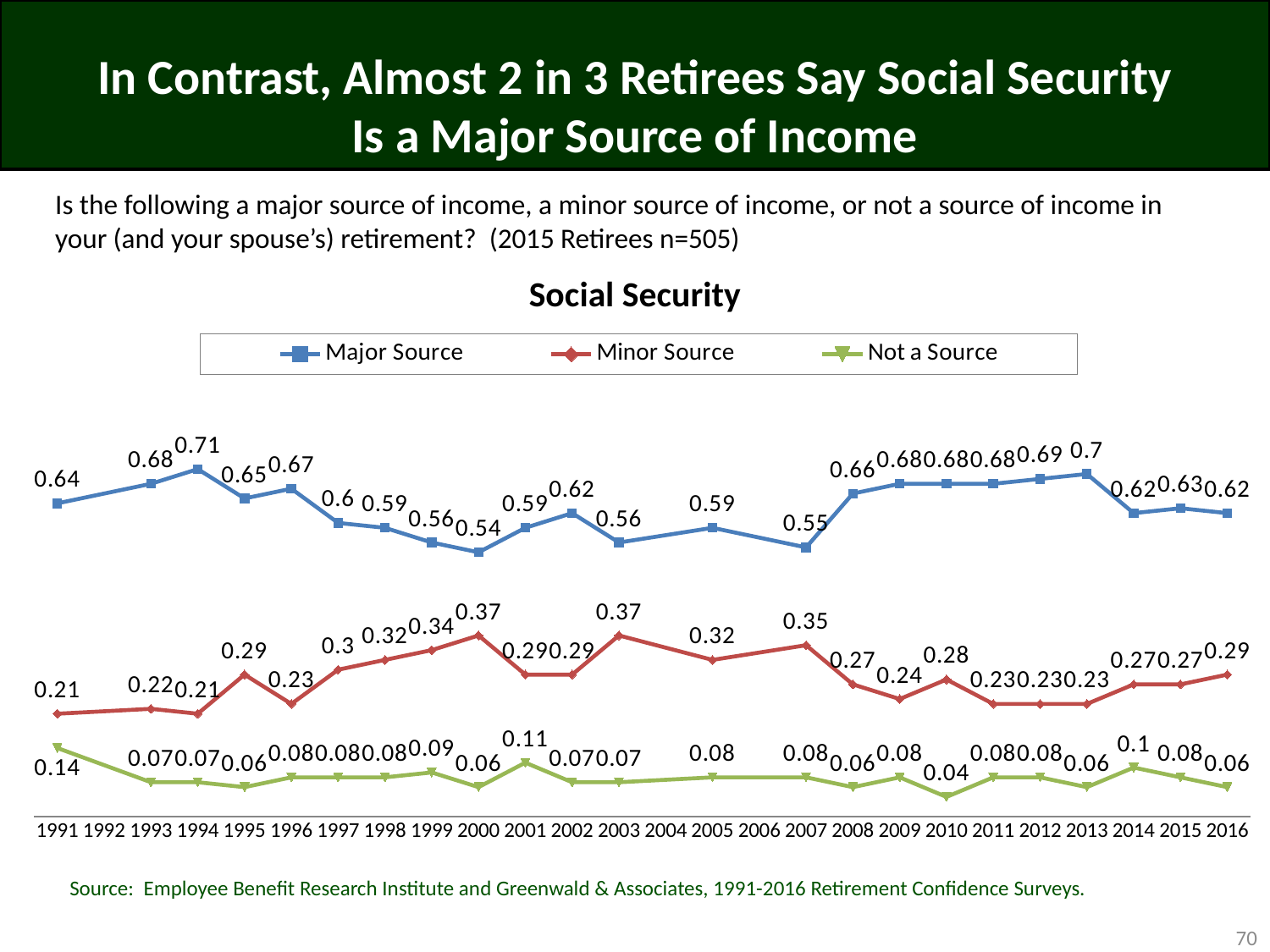
Which is larger, the Minor Source value in 2000 or in 2001? 2000 How many series does the legend list? 3 In which year is the Major Source value highest? 1994 What is the difference between the Major Source value in 2013 and in 2014? 0.08 Which series is shown in green? Not a Source In which year is the Not a Source value highest? 1991 What kind of chart is shown on the slide? line chart What is the value for Not a Source in 2010? 0.04 What is the title of the chart? Social Security What is the value for Major Source in 1994? 0.71 What is the value for Minor Source in 2016? 0.29 In which year is the Major Source value lowest? 2000